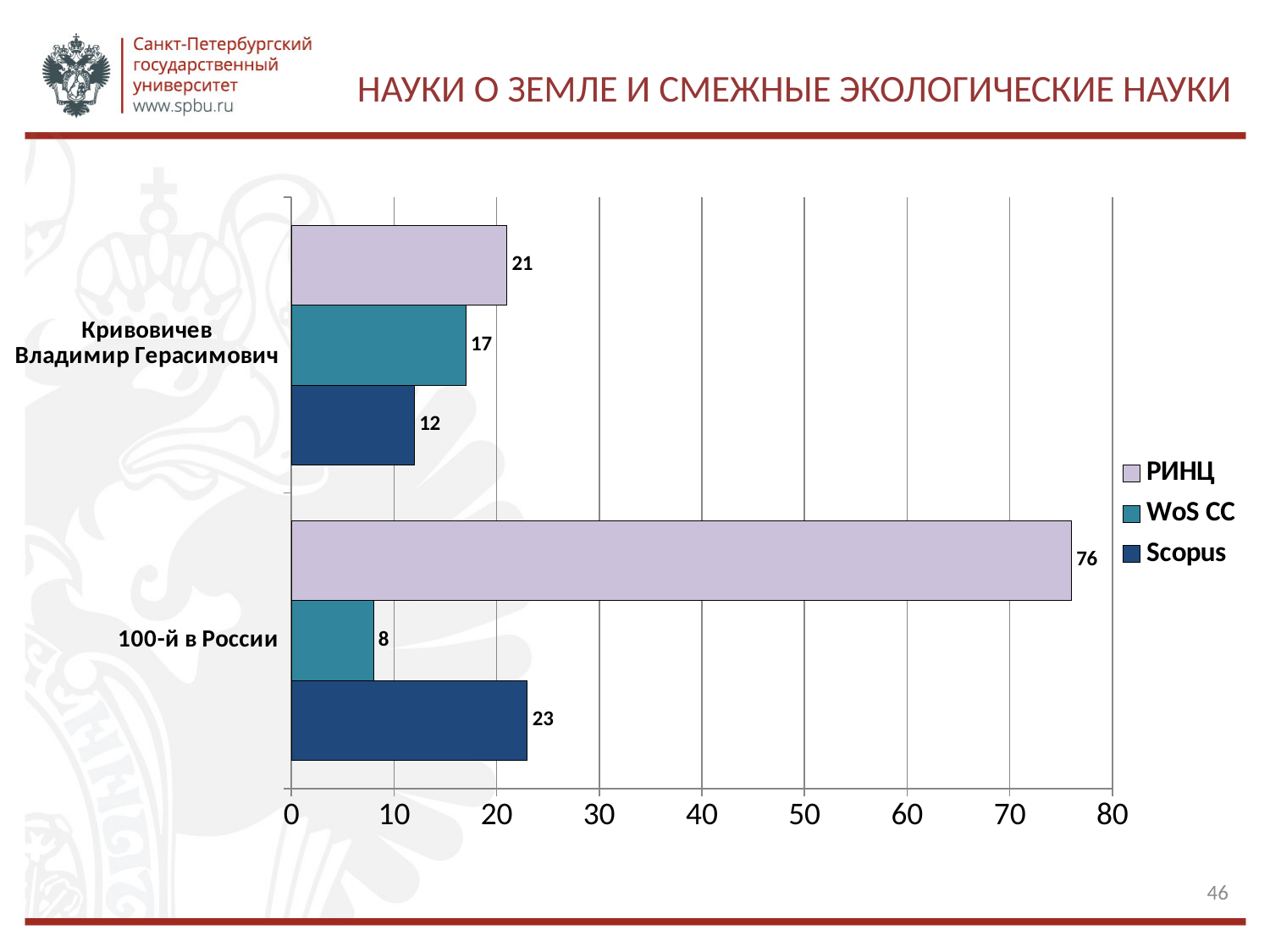
What is the РИНЦ value for Кривовичев Владимир Герасимович? 21 What is the РИНЦ value for 100-й в России? 76 What is the WoS CC value for 100-й в России? 8 How many series does the legend list? 3 What is the Scopus value for Кривовичев Владимир Герасимович? 12 What is the difference between the РИНЦ values for 100-й в России and Кривовичев Владимир Герасимович? 55 Which category has the highest Scopus value? 100-й в России Is the РИНЦ value for 100-й в России greater or less than 70? greater Which category has the lowest WoS CC value? 100-й в России Which is larger: the WoS CC value for Кривовичев Владимир Герасимович or the Scopus value for Кривовичев Владимир Герасимович? WoS CC What kind of chart is shown on the slide? bar chart How many categories are shown on the chart? 2